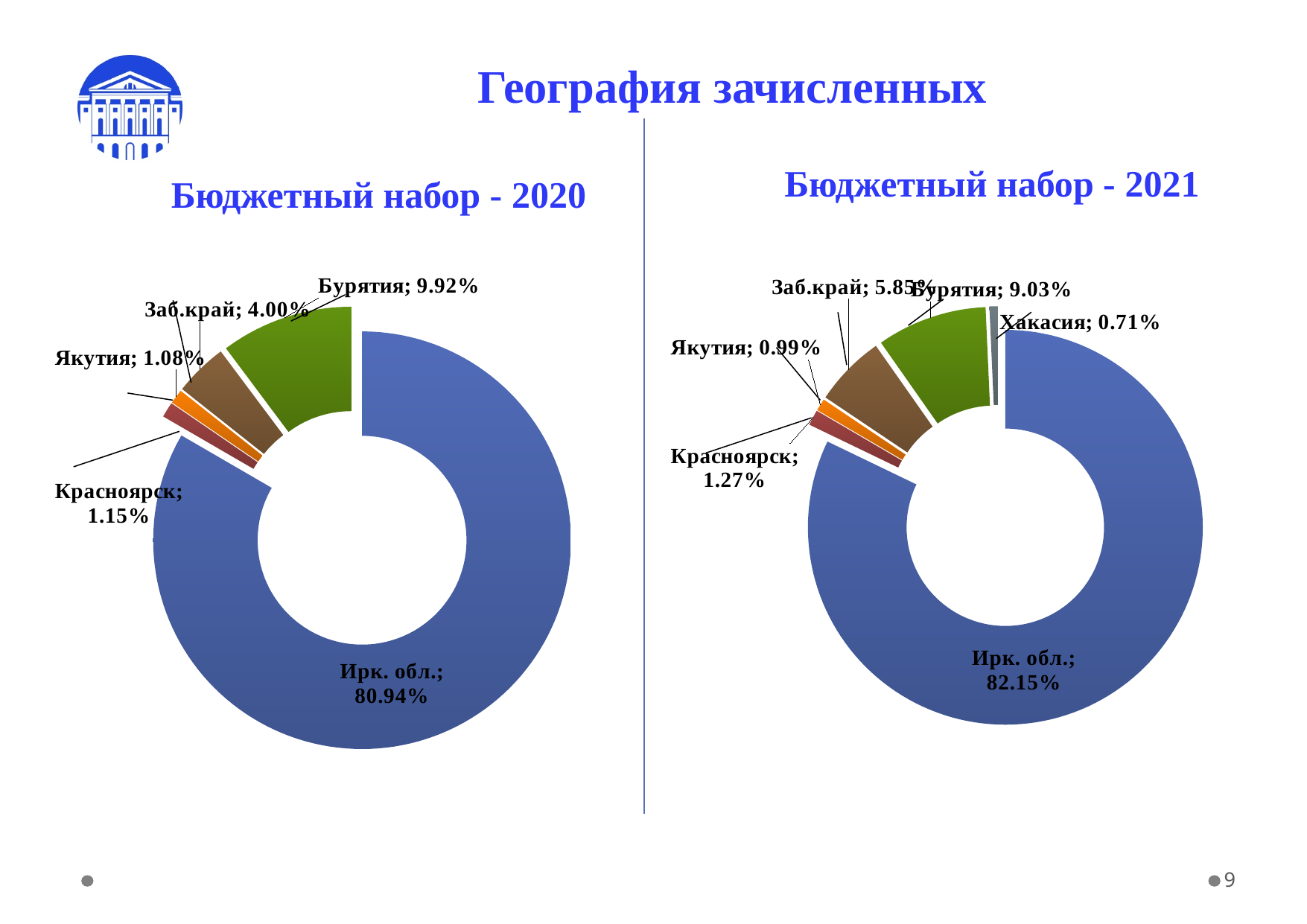
In the 'Бюджетный набор - 2021' chart, which region has the smallest share? Хакасия In the 'Бюджетный набор - 2020' chart, what is the difference between the shares of Бурятия and Заб.край? 5.92% How many regions are shown in the 'Бюджетный набор - 2021' chart? 6 In the 'Бюджетный набор - 2020' chart, which region has the smallest share? Якутия In the 'Бюджетный набор - 2020' chart, which region has the largest share? Ирк. обл. In the 'Бюджетный набор - 2020' chart, what is the value for Бурятия? 9.92% In the 'Бюджетный набор - 2021' chart, what share does Ирк. обл. have? 82.15% In the 'Бюджетный набор - 2021' chart, which is larger: the share of Якутия or the share of Красноярск? Красноярск In the 'Бюджетный набор - 2021' chart, what is the value for Красноярск? 1.27% In the 'Бюджетный набор - 2020' chart, what share does Ирк. обл. have? 80.94% In the 'Бюджетный набор - 2021' chart, what is the value for Хакасия? 0.71% What type of chart is used for 'Бюджетный набор - 2020'? Pie chart (doughnut)